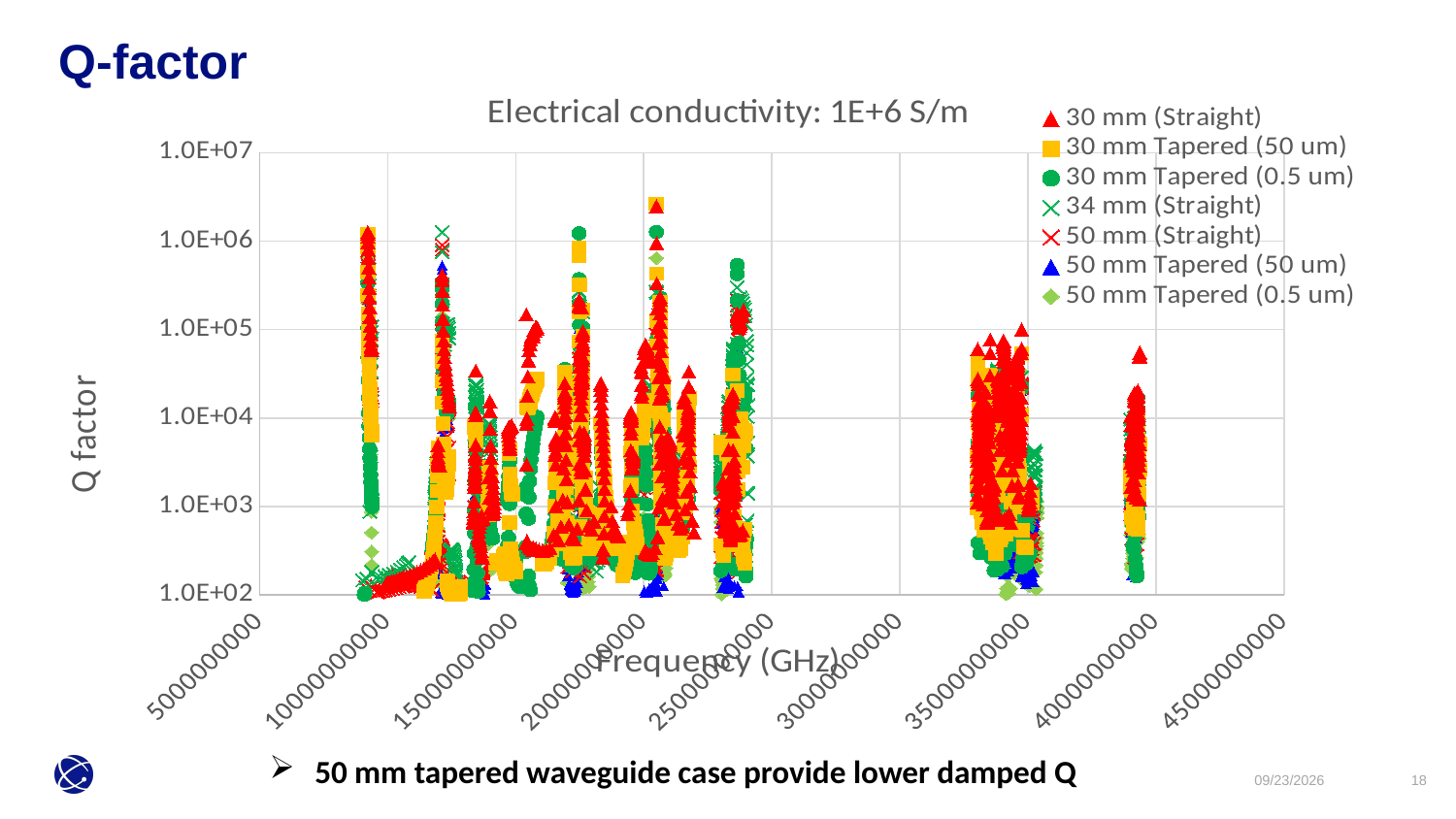
Is the highest Q factor value plotted near a frequency of 40000000000 greater or less than 1.0E+06? less Is the highest Q factor value plotted on the chart greater or less than 1.0E+07? less Is the highest Q factor value plotted on the chart greater or less than 1.0E+06? greater How many series does the legend list? 7 What kind of chart is shown on the slide? Scatter chart What is the title of the chart? Electrical conductivity: 1E+6 S/m What is the label of the y axis? Q factor